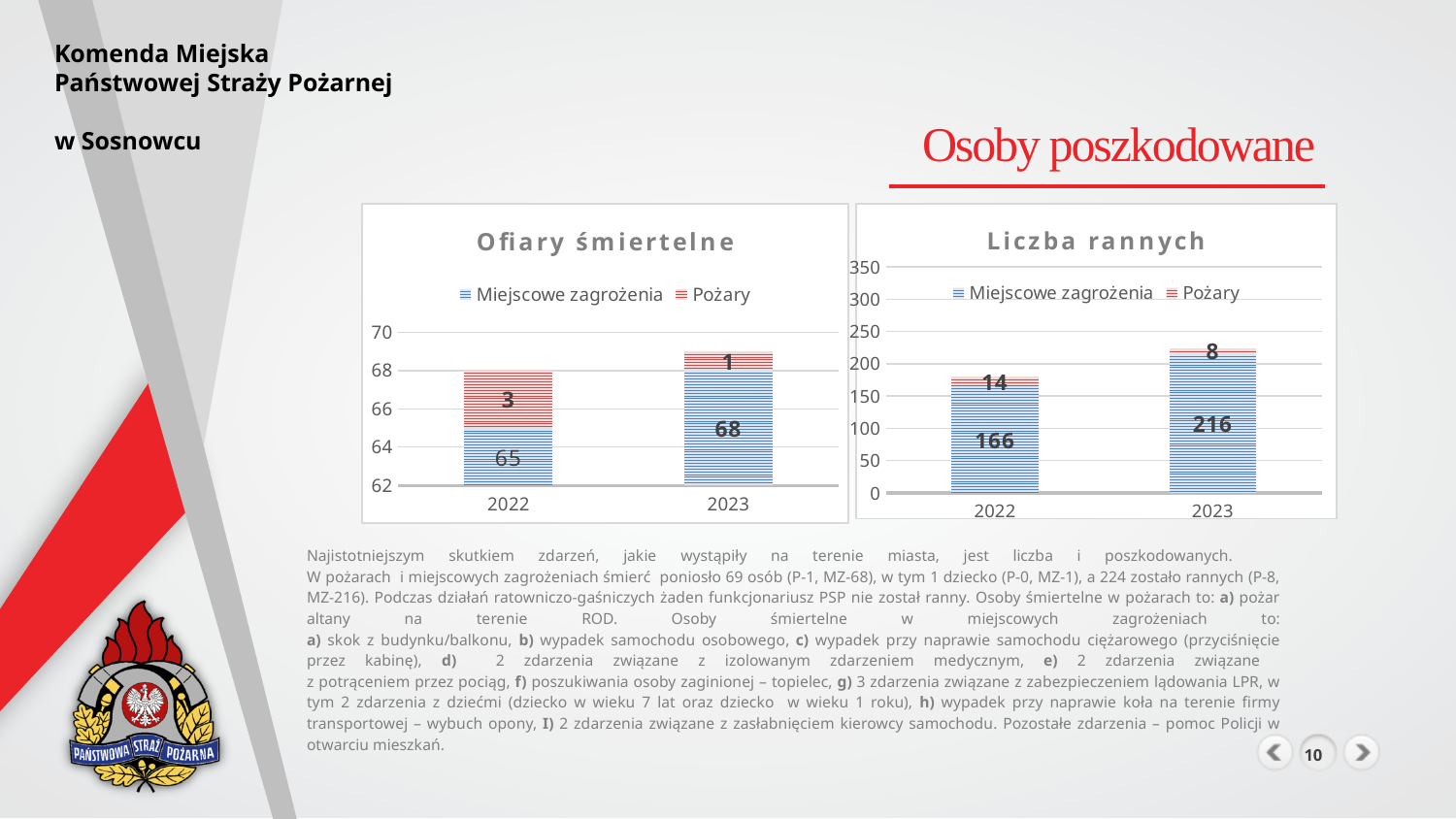
How many categories are shown on the x axis of the 'Ofiary śmiertelne' chart? 2 In the 'Liczba rannych' chart, which year has the higher Pożary value, 2022 or 2023? 2022 In the 'Liczba rannych' chart, what is the value for Miejscowe zagrożenia in 2022? 166 In the 'Liczba rannych' chart, what is the total of the stacked bar for 2023? 224 In the 'Liczba rannych' chart, what is the value for Pożary in 2023? 8 What kind of chart is the 'Liczba rannych' chart? stacked bar chart How many series does the legend of the 'Liczba rannych' chart list? 2 In the 'Ofiary śmiertelne' chart, what is the total of the stacked bar for 2022? 68 In the 'Liczba rannych' chart, what is the difference between the Miejscowe zagrożenia values for 2023 and 2022? 50 In the 'Ofiary śmiertelne' chart, what is the value for Miejscowe zagrożenia in 2023? 68 In the 'Ofiary śmiertelne' chart, what is the value for Pożary in 2022? 3 In the 'Ofiary śmiertelne' chart, does the Miejscowe zagrożenia value rise or fall from 2022 to 2023? rise